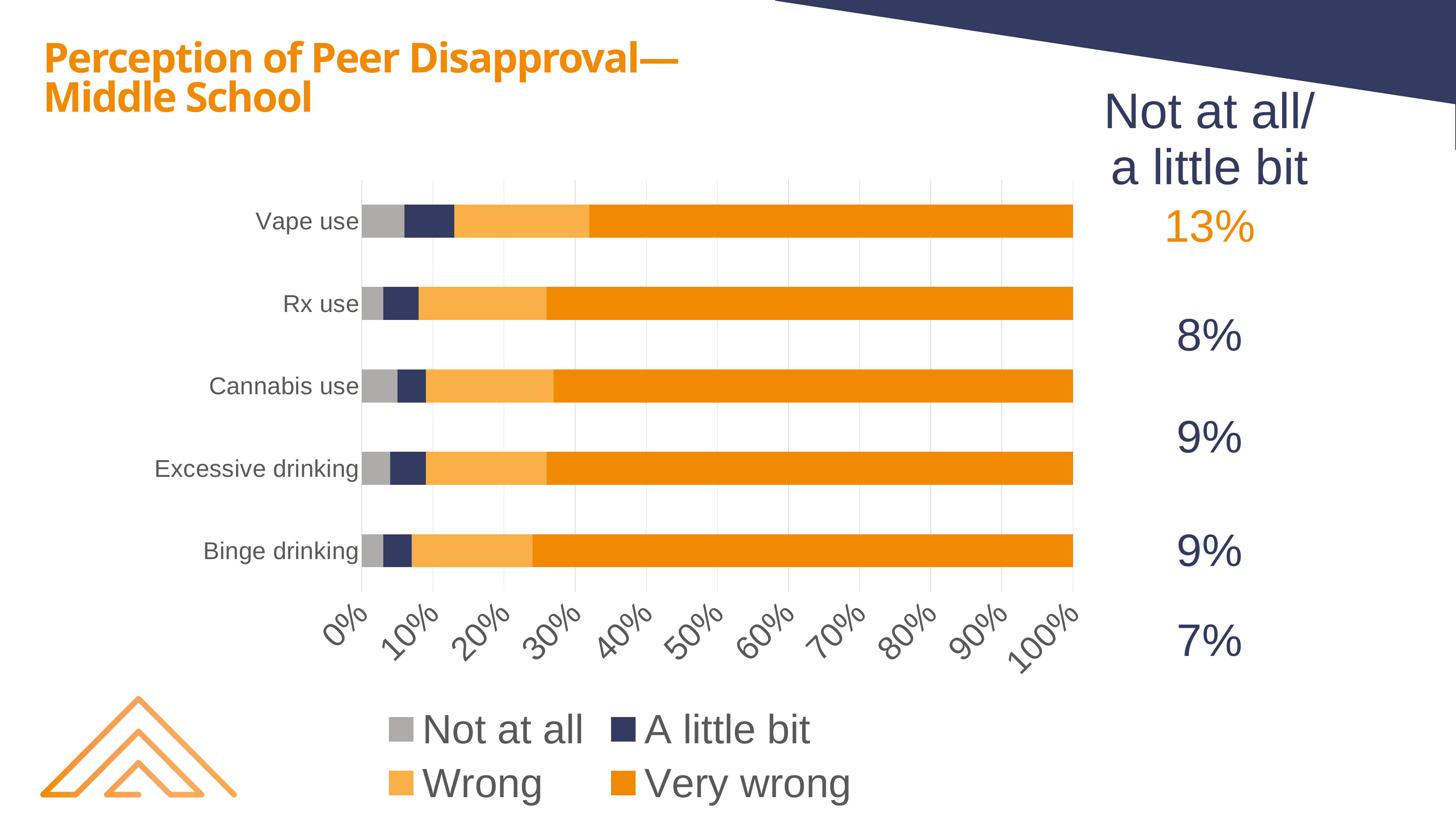
What is the combined 'Not at all/a little bit' percentage shown for Binge drinking? 7% What is the difference between the combined 'Not at all/a little bit' percentages for Vape use and Binge drinking? 6 percentage points Is the 'Very wrong' share for Vape use greater or less than 60%? greater What is the title of the slide's chart? Perception of Peer Disapproval—Middle School How many categories are plotted on the chart? 5 How many series does the legend list? 4 What kind of chart is shown on the slide? Stacked bar chart Which has a larger combined 'Not at all/a little bit' percentage, Vape use or Rx use? Vape use Which category has the lowest combined 'Not at all/a little bit' percentage? Binge drinking What is the combined 'Not at all/a little bit' percentage shown for Rx use? 8% What is the combined 'Not at all/a little bit' percentage shown for Vape use? 13% Which category has the highest combined 'Not at all/a little bit' percentage? Vape use